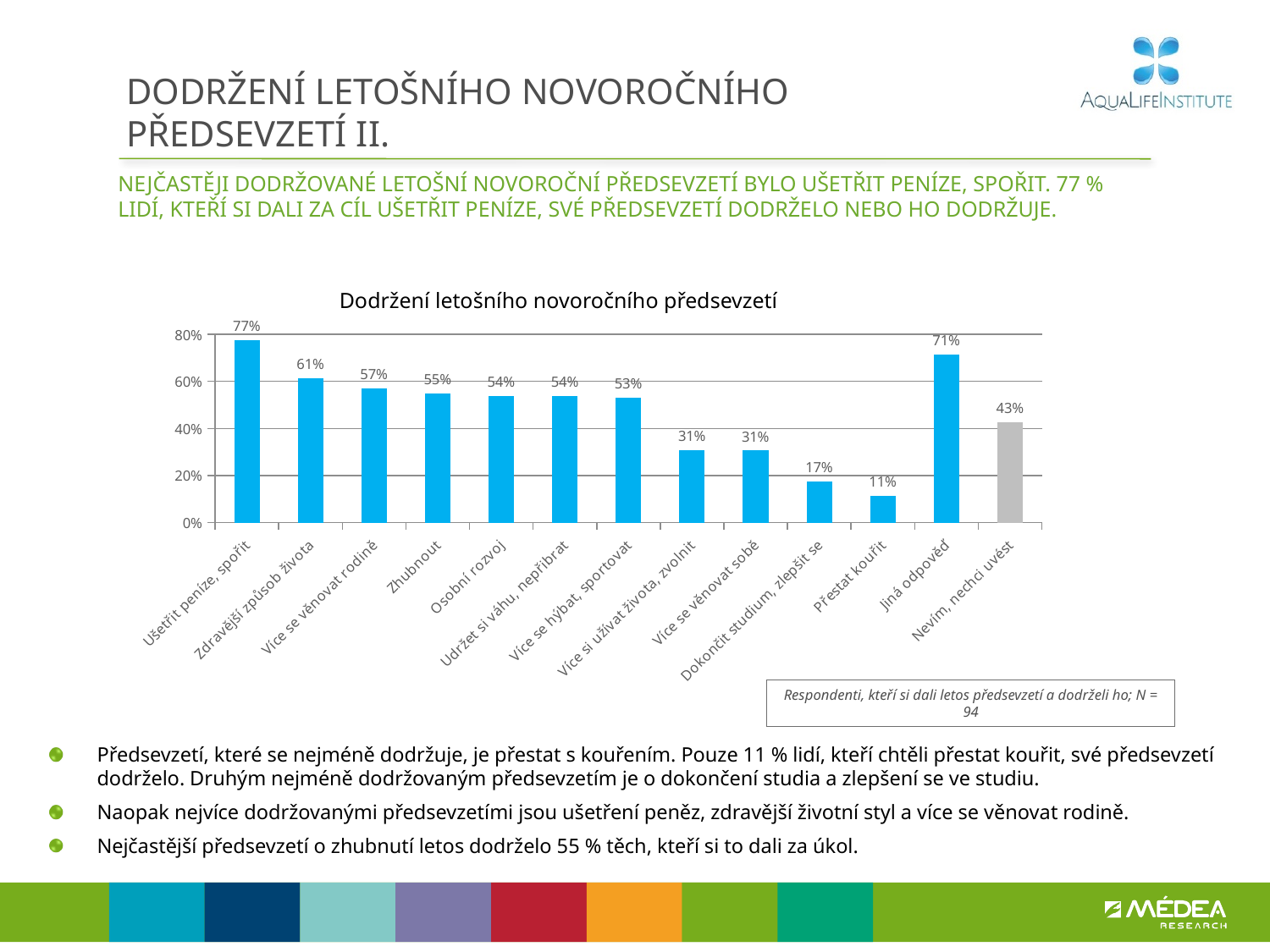
What is the value for "Přestat kouřit" in the chart? 11% What is the difference between the values for "Ušetřit peníze, spořit" and "Zdravější způsob života"? 16% What type of chart is shown on the slide? Bar chart How many categories are shown on the x axis of the chart? 13 What is the value for "Nevím, nechci uvést" in the chart? 43% What is the value for "Ušetřit peníze, spořit" in the chart? 77% Which category has the lowest value in the chart? Přestat kouřit What is the difference between the values for "Dokončit studium, zlepšit se" and "Přestat kouřit"? 6% What is the title of the chart? Dodržení letošního novoročního předsevzetí Which category has the highest value in the chart? Ušetřit peníze, spořit Which is larger, the value for "Jiná odpověď" or the value for "Zdravější způsob života"? Jiná odpověď What is the value for "Zhubnout" in the chart? 55%